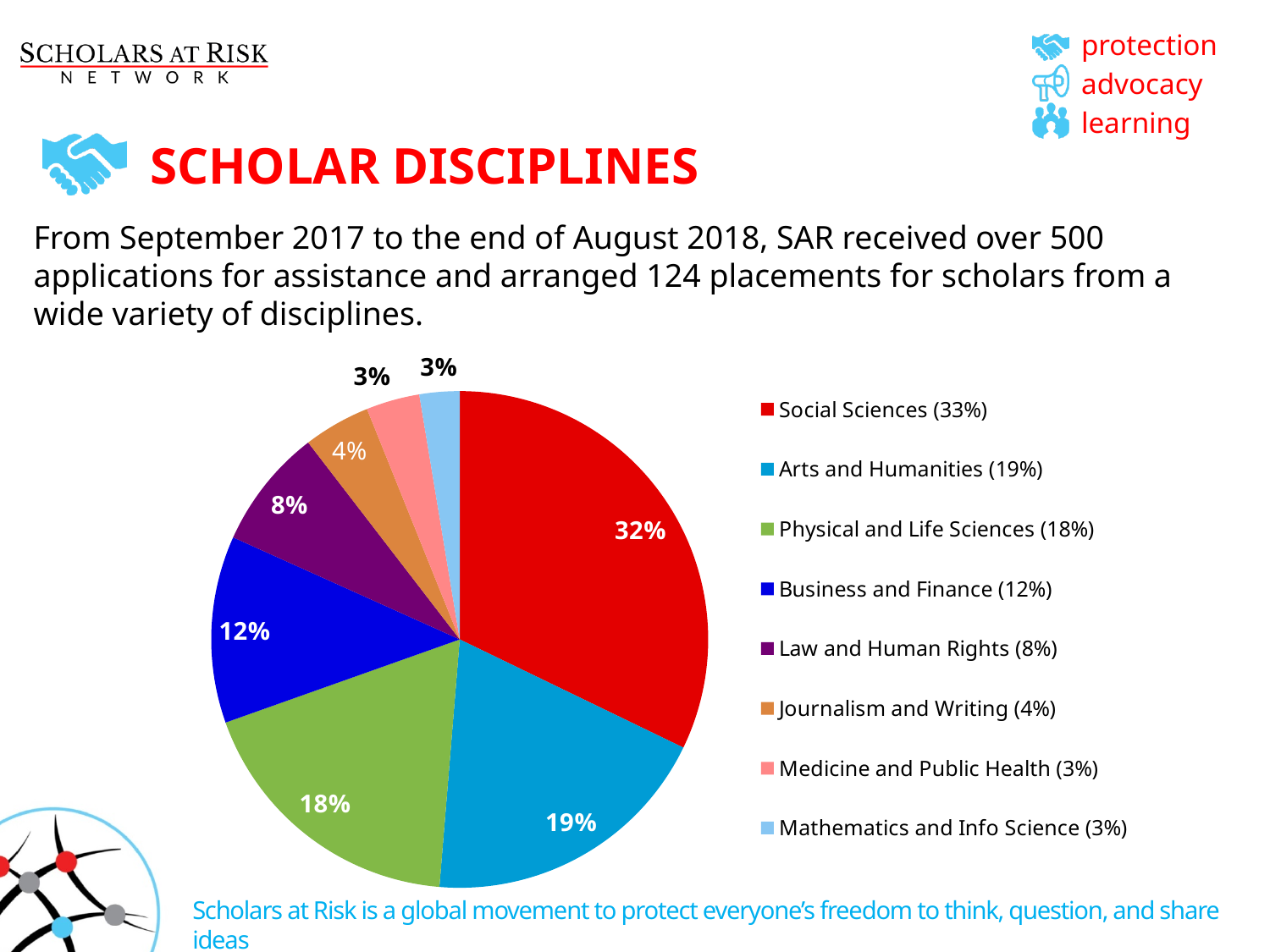
Which two disciplines each have a 3% share in the pie chart? Medicine and Public Health; Mathematics and Info Science What is the share shown for Physical and Life Sciences in the pie chart? 18% What colour is the Social Sciences slice in the pie chart? Red What kind of chart is shown on the slide? Pie chart How many slices does the pie chart have? 8 What is the share shown for Law and Human Rights in the pie chart? 8% What is the share shown for Business and Finance in the pie chart? 12% What is the share shown for Arts and Humanities in the pie chart? 19% Which slice is larger in the pie chart, Business and Finance or Law and Human Rights? Business and Finance What is the share shown for Journalism and Writing in the pie chart? 4% What is the difference in percentage points between Arts and Humanities and Physical and Life Sciences in the pie chart? 1% Which discipline has the largest slice of the pie chart? Social Sciences